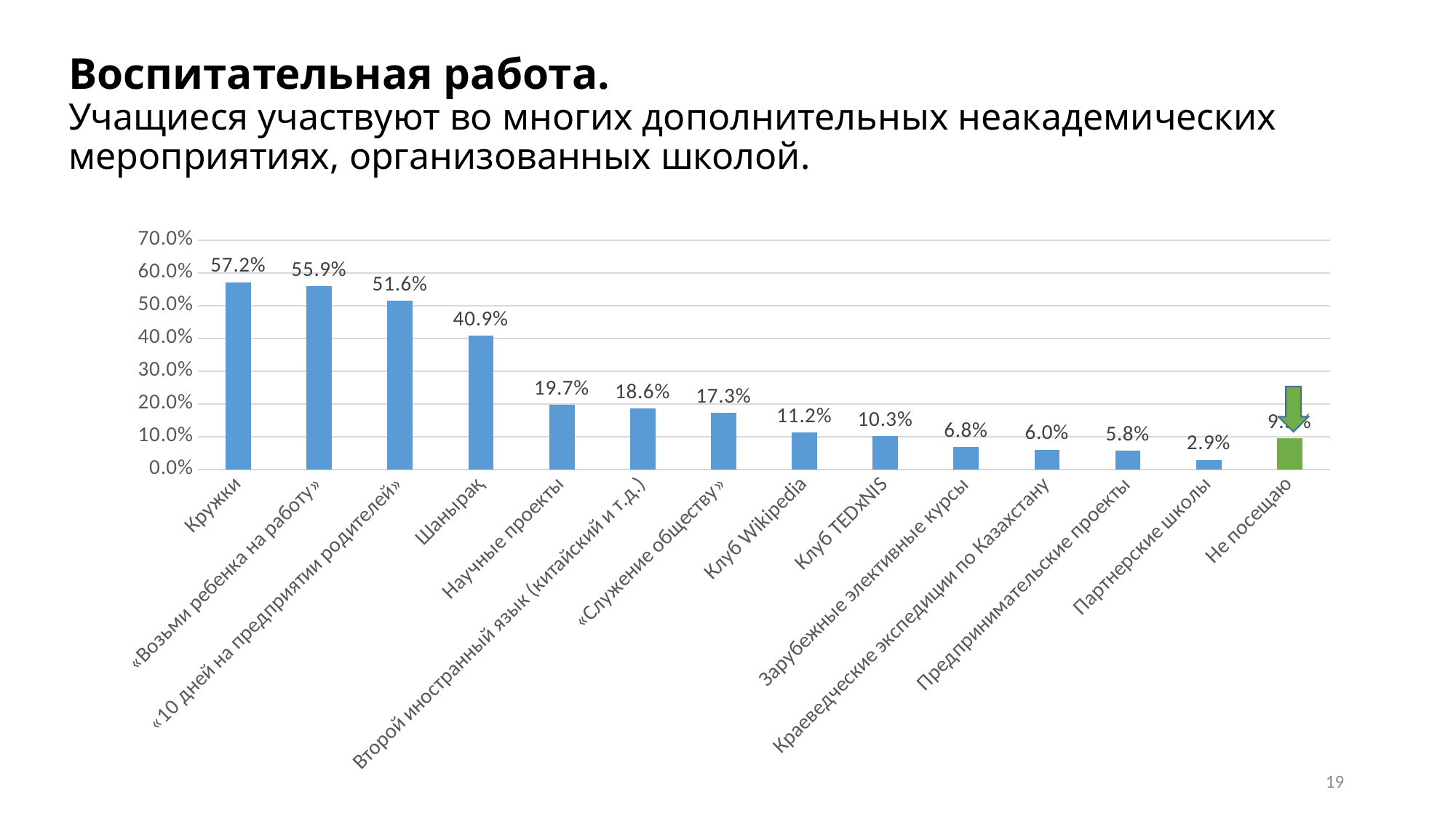
What is the value for Клуб TEDxNIS? 10.3% Which category has the lowest value? Партнерские школы Is the value for Не посещаю greater or less than 20.0%? less What is the difference between the values for Кружки and «Возьми ребенка на работу»? 1.3% What is the value for Партнерские школы? 2.9% Which category has the highest value? Кружки What is the value for Шанырақ? 40.9% What is the value for Кружки? 57.2% Which bar is coloured green instead of blue? Не посещаю Which is larger, the value for Научные проекты or the value for «Служение обществу»? Научные проекты How many categories are shown on the x axis? 14 What kind of chart is shown on the slide? bar chart